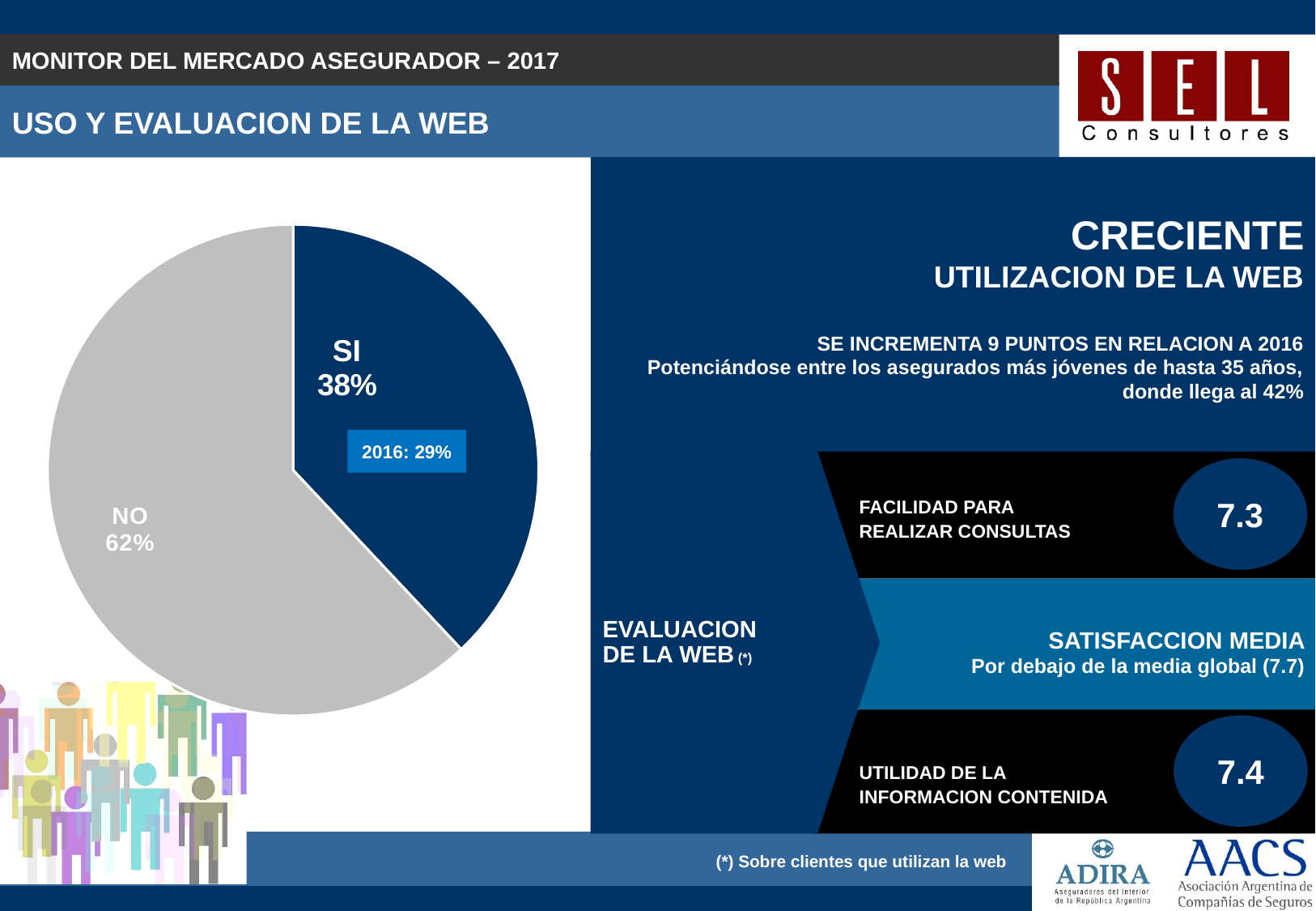
What colour is the SI slice of the pie chart? dark blue What value for 2016 is shown in the box next to the SI slice? 29% Which slice of the pie chart is the largest? NO How many slices does the pie chart have? 2 What is the difference in percentage points between the NO slice and the SI slice? 24 Which is larger in the pie chart, the SI slice or the NO slice? NO What share of the pie chart is labelled NO? 62% Which slice of the pie chart is the smallest? SI What share of the pie chart is labelled SI? 38% By how many percentage points did the SI share increase from 2016 (29%) to the 38% shown? 9 What colour is the NO slice of the pie chart? grey What kind of chart is shown on the slide? pie chart